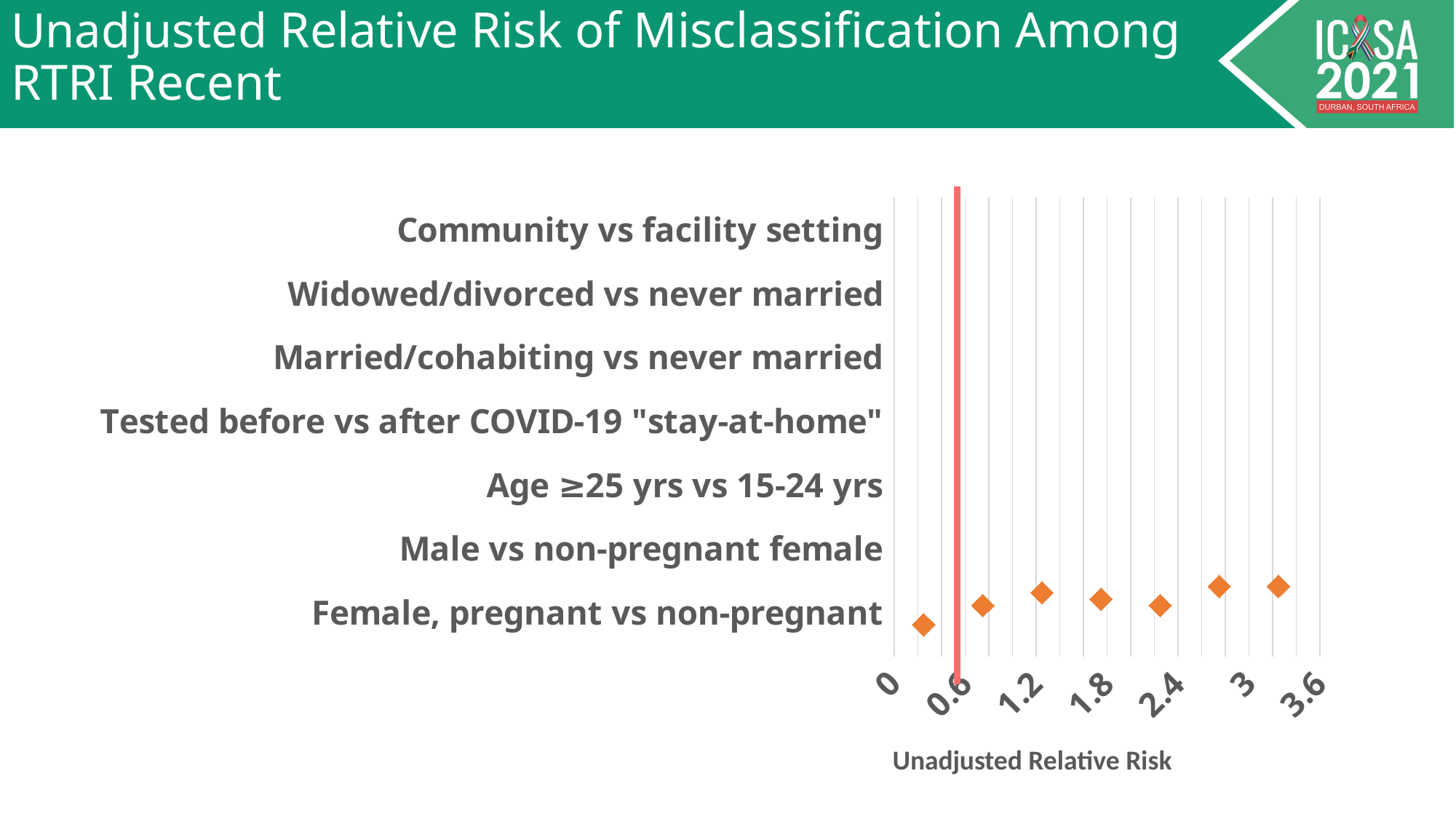
How many markers lie to the right of the red vertical reference line? 6 What is the highest tick value shown on the horizontal axis? 3.6 Is the value of the leftmost marker greater or less than 0.6? less What is the title of the horizontal axis? Unadjusted Relative Risk How many comparison categories are listed on the vertical axis of the chart? 7 What kind of chart is shown on the slide? scatter chart How many orange markers are plotted on the chart? 7 Which category label appears at the top of the vertical axis? Community vs facility setting Is the value of the rightmost marker greater or less than 3? greater